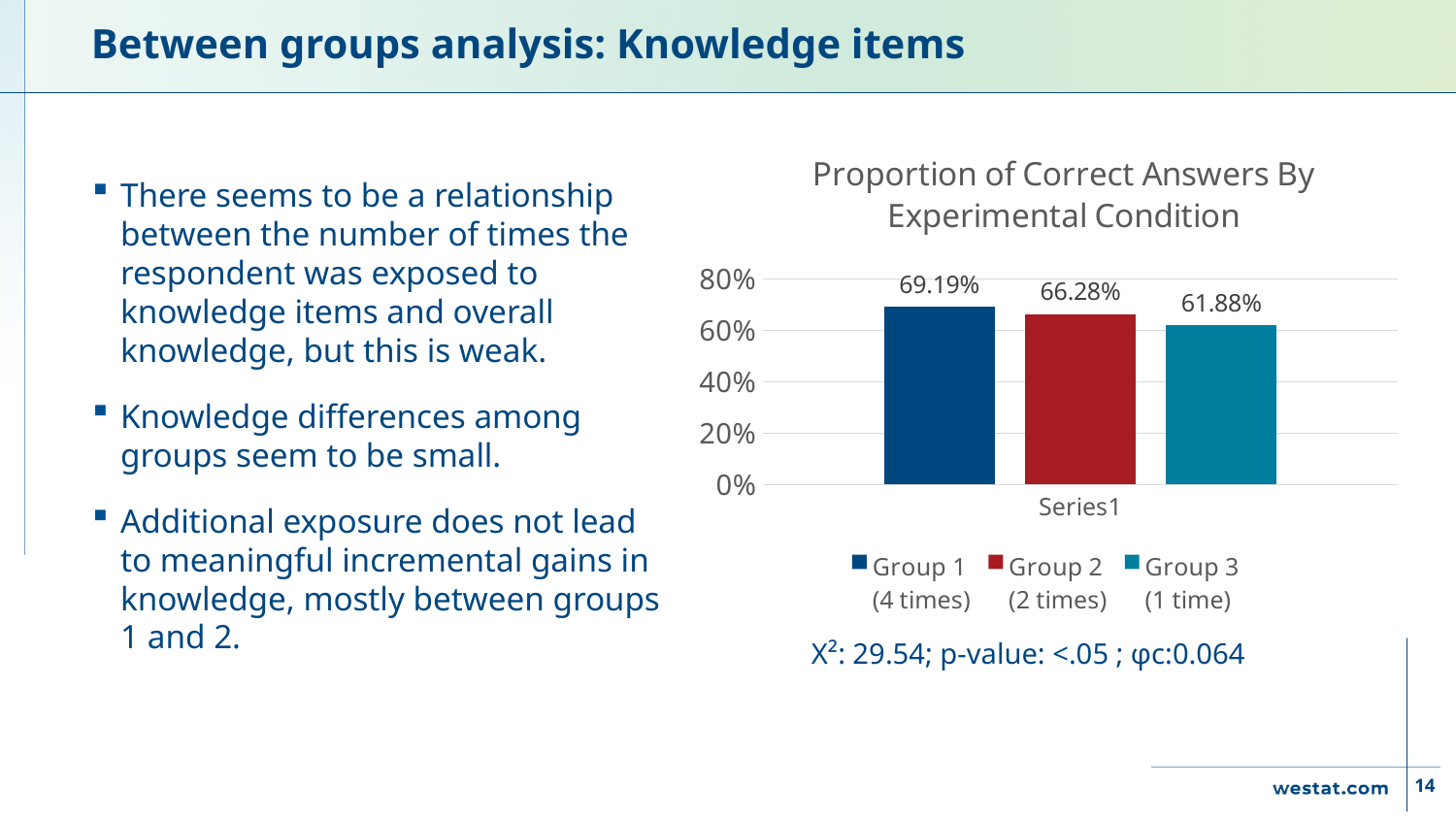
What is the title of the chart? Proportion of Correct Answers By Experimental Condition What is the proportion of correct answers for Group 1 (4 times)? 69.19% What kind of chart is shown on the slide? Bar chart What is the difference in proportion of correct answers between Group 2 (2 times) and Group 3 (1 time)? 4.40% Which group has the highest proportion of correct answers? Group 1 (4 times) Is the value for Group 3 (1 time) greater or less than 60%? greater Which has a higher proportion of correct answers, Group 1 (4 times) or Group 2 (2 times)? Group 1 (4 times) What is the difference in proportion of correct answers between Group 1 (4 times) and Group 3 (1 time)? 7.31% Which group has the lowest proportion of correct answers? Group 3 (1 time) What is the proportion of correct answers for Group 3 (1 time)? 61.88% How many series does the legend list? 3 What is the proportion of correct answers for Group 2 (2 times)? 66.28%